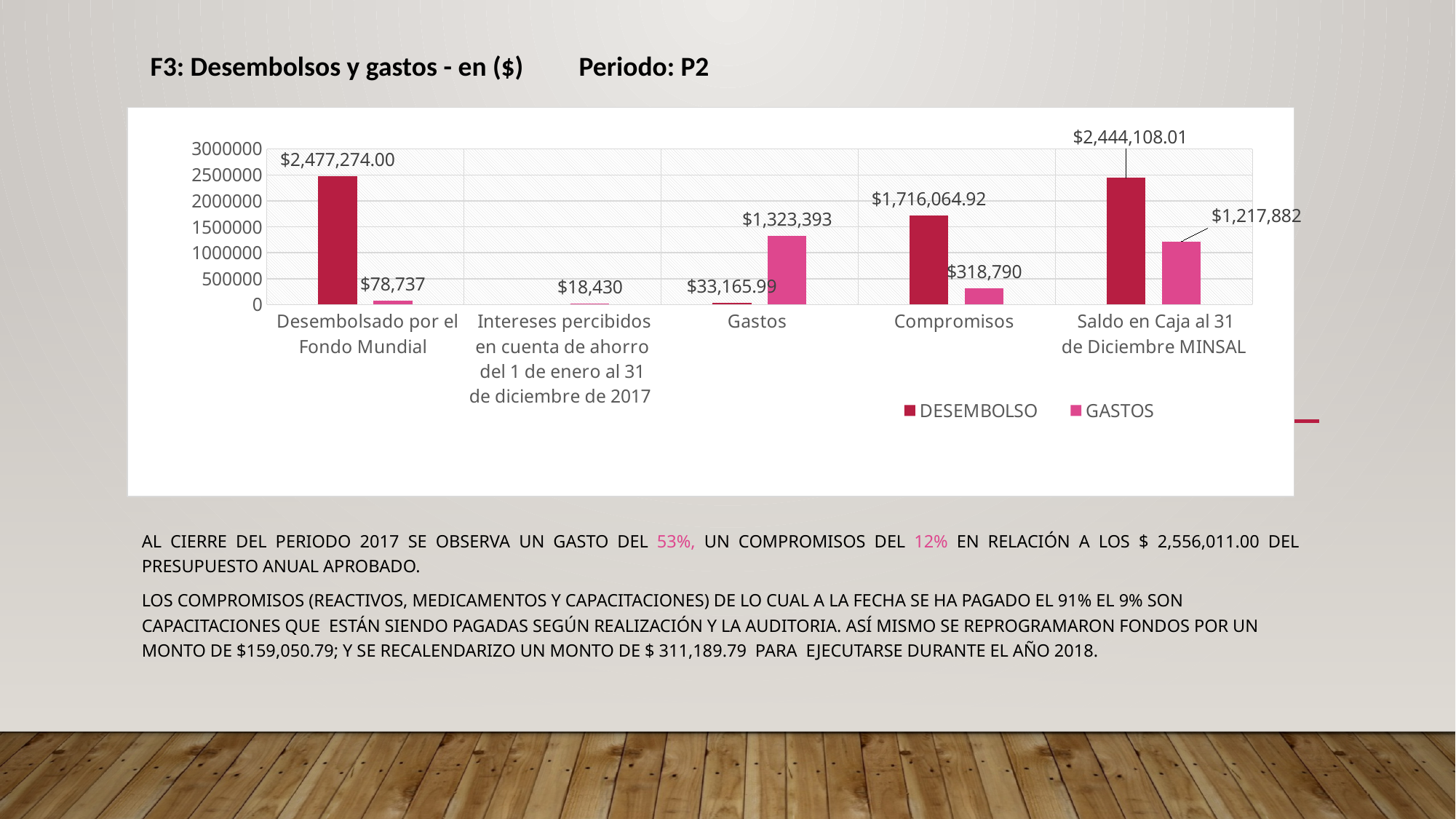
What is the DESEMBOLSO value for 'Compromisos'? $1,716,064.92 How many categories are shown on the x axis of the chart? 5 What is the difference between the DESEMBOLSO and GASTOS values for 'Saldo en Caja al 31 de Diciembre MINSAL'? $1,226,226.01 What is the GASTOS value for the 'Gastos' category? $1,323,393 Which category has the highest DESEMBOLSO value? Desembolsado por el Fondo Mundial For 'Compromisos', which is larger: the DESEMBOLSO value or the GASTOS value? DESEMBOLSO What is the DESEMBOLSO value for 'Desembolsado por el Fondo Mundial'? $2,477,274.00 What type of chart is shown on the slide? Bar chart How many series does the chart legend list? 2 Which category has the highest GASTOS value? Gastos What is the GASTOS value for 'Saldo en Caja al 31 de Diciembre MINSAL'? $1,217,882 What is the GASTOS value for 'Compromisos'? $318,790